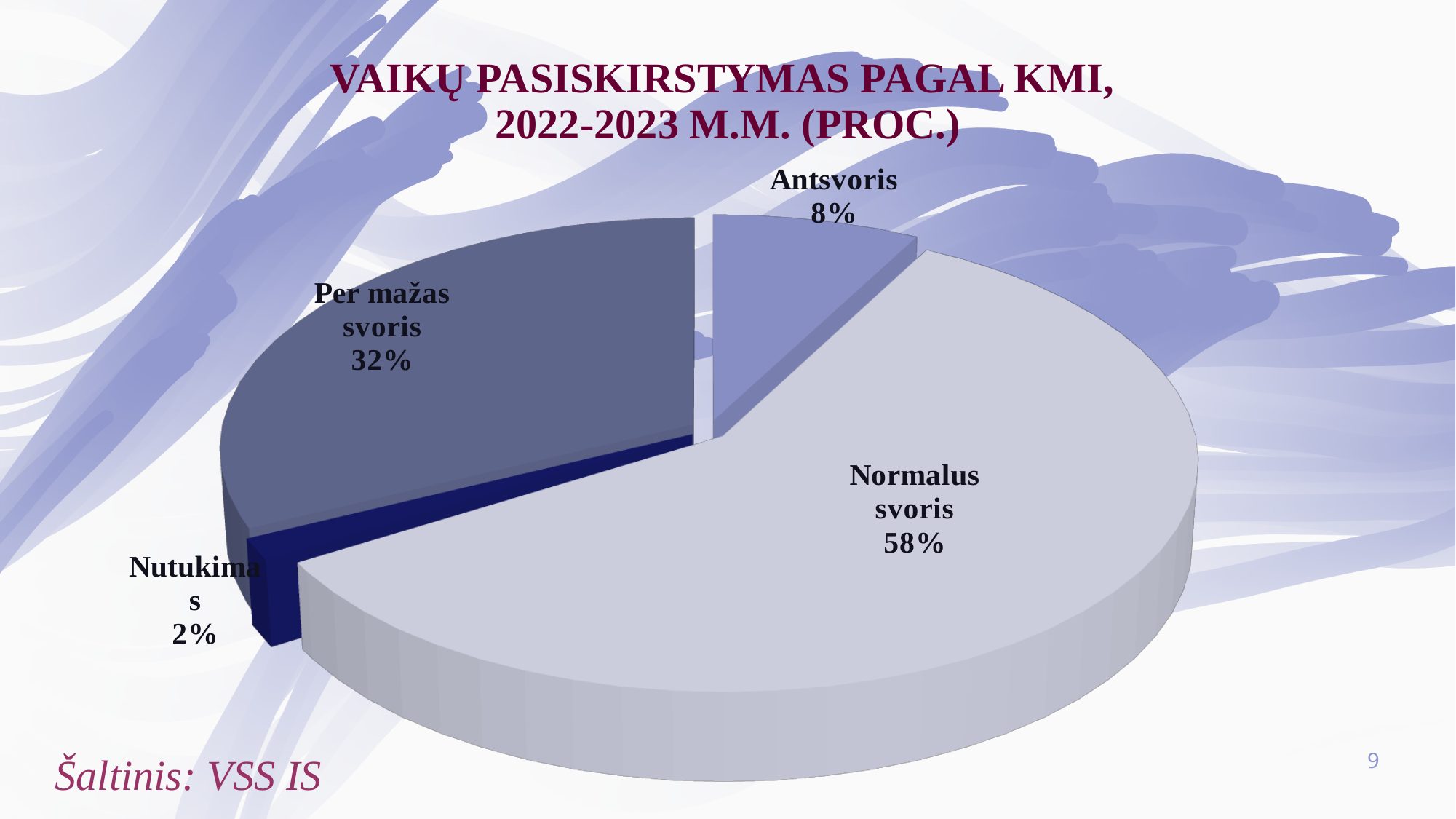
What is the combined share of Antsvoris and Nutukimas? 10% Which is larger, the value for Antsvoris or the value for Nutukimas? Antsvoris Which category has the largest share of the pie? Normalus svoris What is the difference between the values for Normalus svoris and Per mažas svoris? 26 percentage points What type of chart is shown on the slide? Pie chart What is the value for Nutukimas? 2% What is the title of the chart? VAIKŲ PASISKIRSTYMAS PAGAL KMI, 2022-2023 M.M. (PROC.) What is the value for Normalus svoris? 58% Which category has the smallest share of the pie? Nutukimas What is the value for Per mažas svoris? 32% What is the value for Antsvoris? 8% How many categories are shown in the pie chart? 4